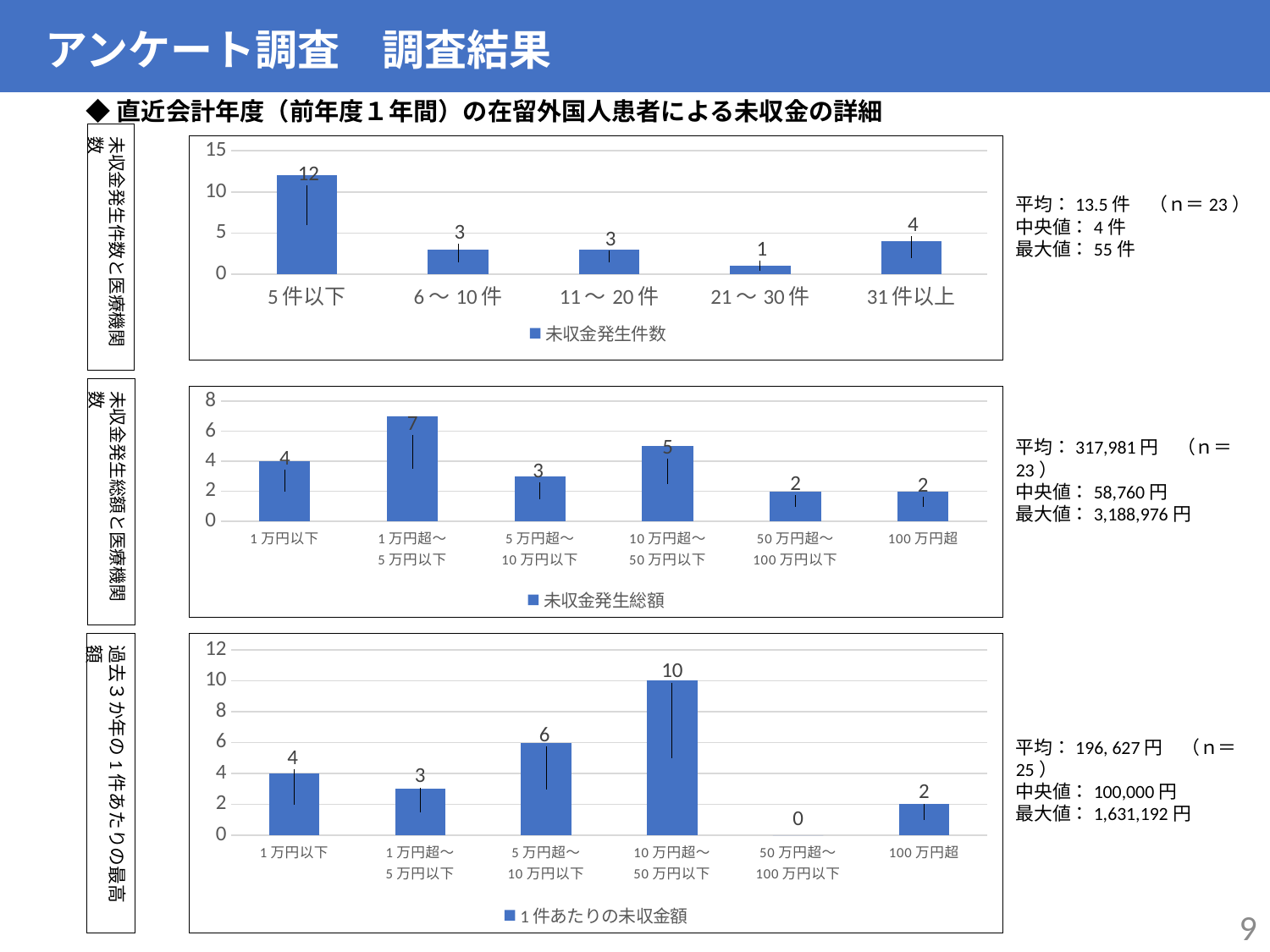
In the bottom chart (1件あたりの未収金額), which category has a value of 0? 50万円超～100万円以下 How many series does the legend of the middle chart list? 1 What type of chart is the bottom chart (1件あたりの未収金額)? Bar chart In the bottom chart (1件あたりの未収金額), what is the value for 10万円超～50万円以下? 10 In the bottom chart (1件あたりの未収金額), what is the difference between the values for 10万円超～50万円以下 and 5万円超～10万円以下? 4 In the middle chart (未収金発生総額), which is larger: the value for 1万円以下 or the value for 5万円超～10万円以下? 1万円以下 In the top chart (未収金発生件数), how many categories are shown on the x axis? 5 In the middle chart (未収金発生総額), what is the value for 10万円超～50万円以下? 5 In the middle chart (未収金発生総額), which category has the highest value? 1万円超～5万円以下 In the top chart (未収金発生件数), what is the difference between the values for 5件以下 and 31件以上? 8 In the top chart (未収金発生件数), what is the value for 5件以下? 12 In the top chart (未収金発生件数), which category has the lowest value? 21～30件